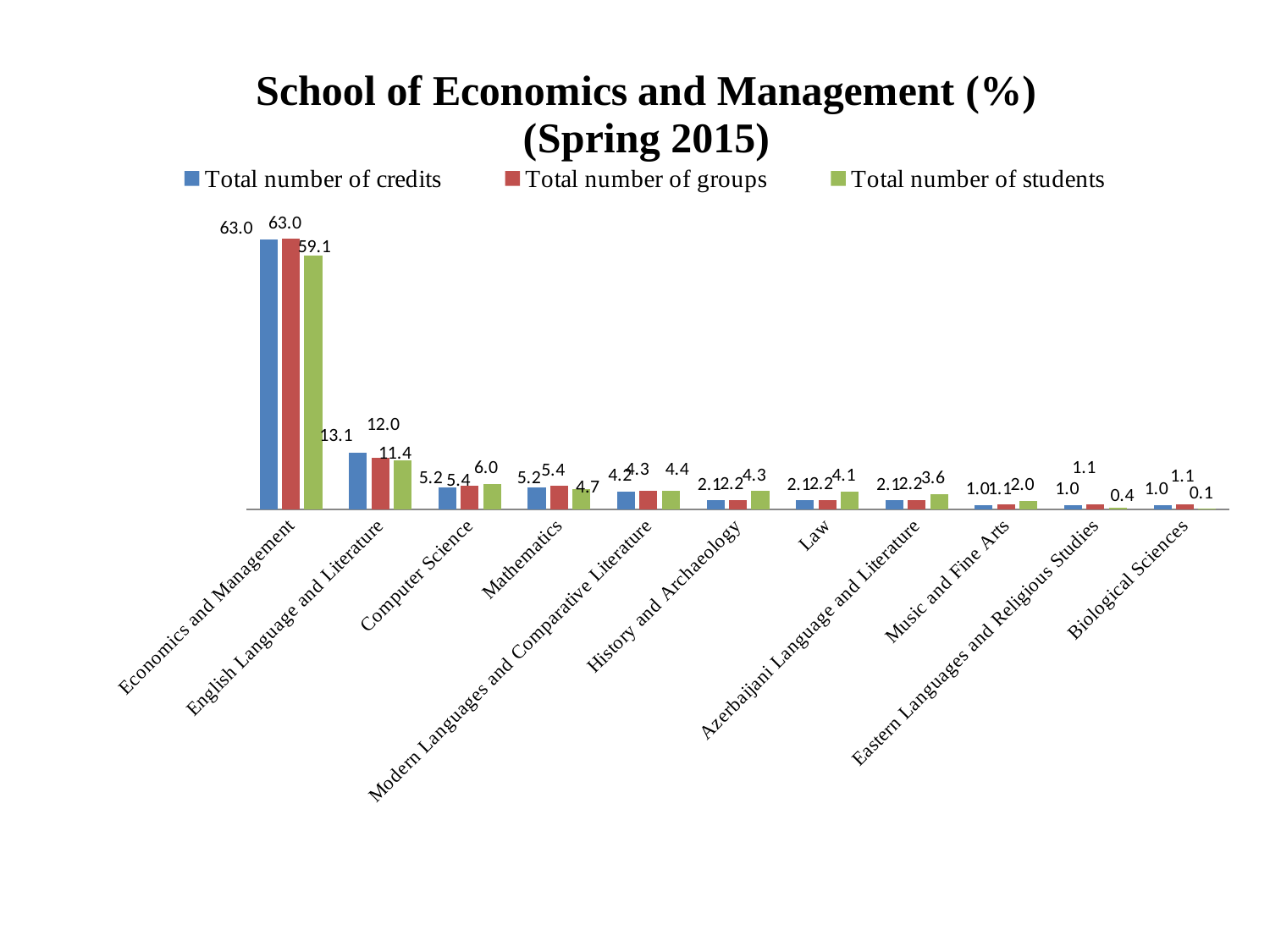
Which is larger for English Language and Literature: Total number of credits or Total number of students? Total number of credits What kind of chart is shown on the slide? Bar chart What is the Total number of students value for Economics and Management? 59.1 How many series does the legend list? 3 What is the difference between the Total number of credits and the Total number of students for Economics and Management? 3.9 Which category has the lowest Total number of students? Biological Sciences What is the Total number of groups value for Mathematics? 5.4 How many categories are shown on the x axis? 11 What is the Total number of students value for Biological Sciences? 0.1 Which category has the highest Total number of credits? Economics and Management What is the Total number of credits value for English Language and Literature? 13.1 What is the Total number of students value for Computer Science? 6.0